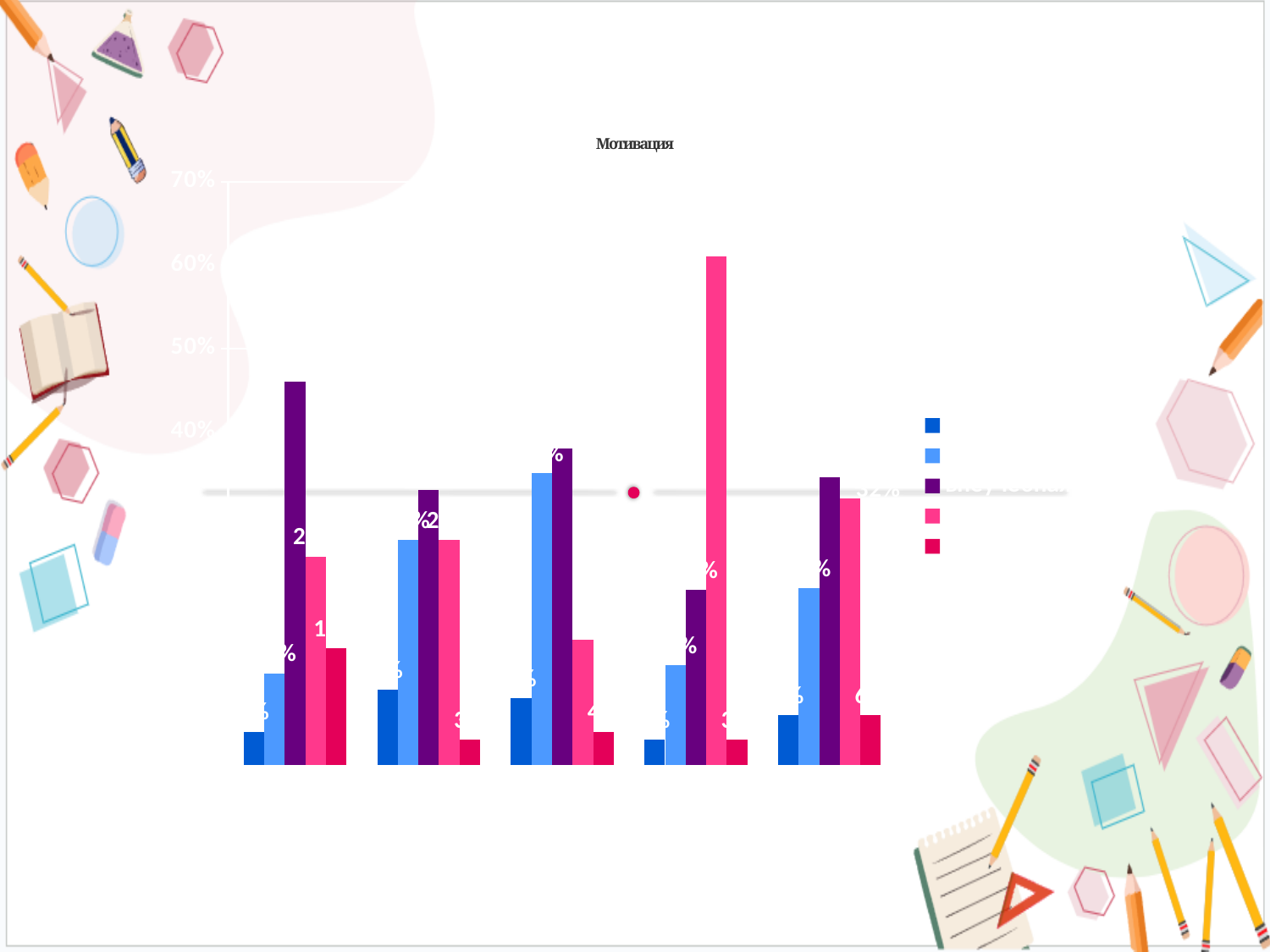
What kind of chart is shown on the slide? bar chart What is the title of the chart? Мотивация Is the tallest bar in the third group from the left greater or less than 40%? less Is the tallest bar in the first group from the left greater or less than 40%? greater What is the highest value shown on the vertical axis? 70% What colour is the tallest bar in the chart? pink How many series does the legend list? 5 Which is taller: the tallest bar in the fourth group or the tallest bar in the first group? the tallest bar in the fourth group Is the tallest bar in the first group from the left greater or less than 50%? less How many groups of bars are plotted along the x axis? 5 Which group of bars, counting from the left, contains the tallest bar in the chart? fourth